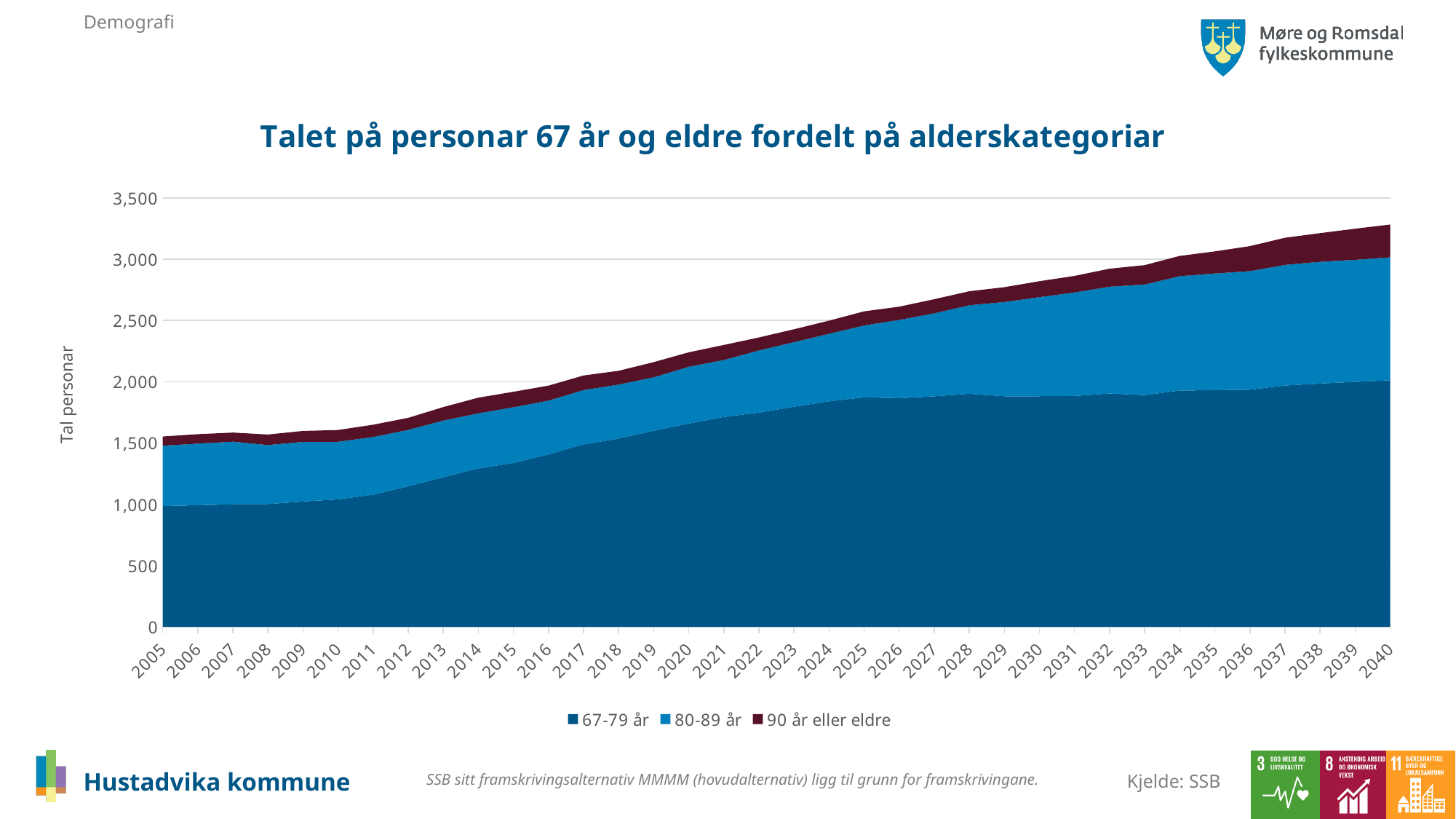
Is the total value for 2030 greater or less than 3,000? less Does the total number of persons 67 år og eldre rise or fall from 2005 to 2040? Rise Is the value for 67-79 år in 2020 greater or less than 1,500? greater What is the title of the chart? Talet på personar 67 år og eldre fordelt på alderskategoriar Which is larger, the total for 2040 or the total for 2005? 2040 Which year has the highest total number of persons 67 år og eldre? 2040 How many series does the legend list? 3 What are the three age categories listed in the legend? 67-79 år, 80-89 år, 90 år eller eldre What kind of chart is shown on the slide? Stacked area chart Is the total value for 2040 greater or less than 3,000? greater How many years are shown along the x axis? 36